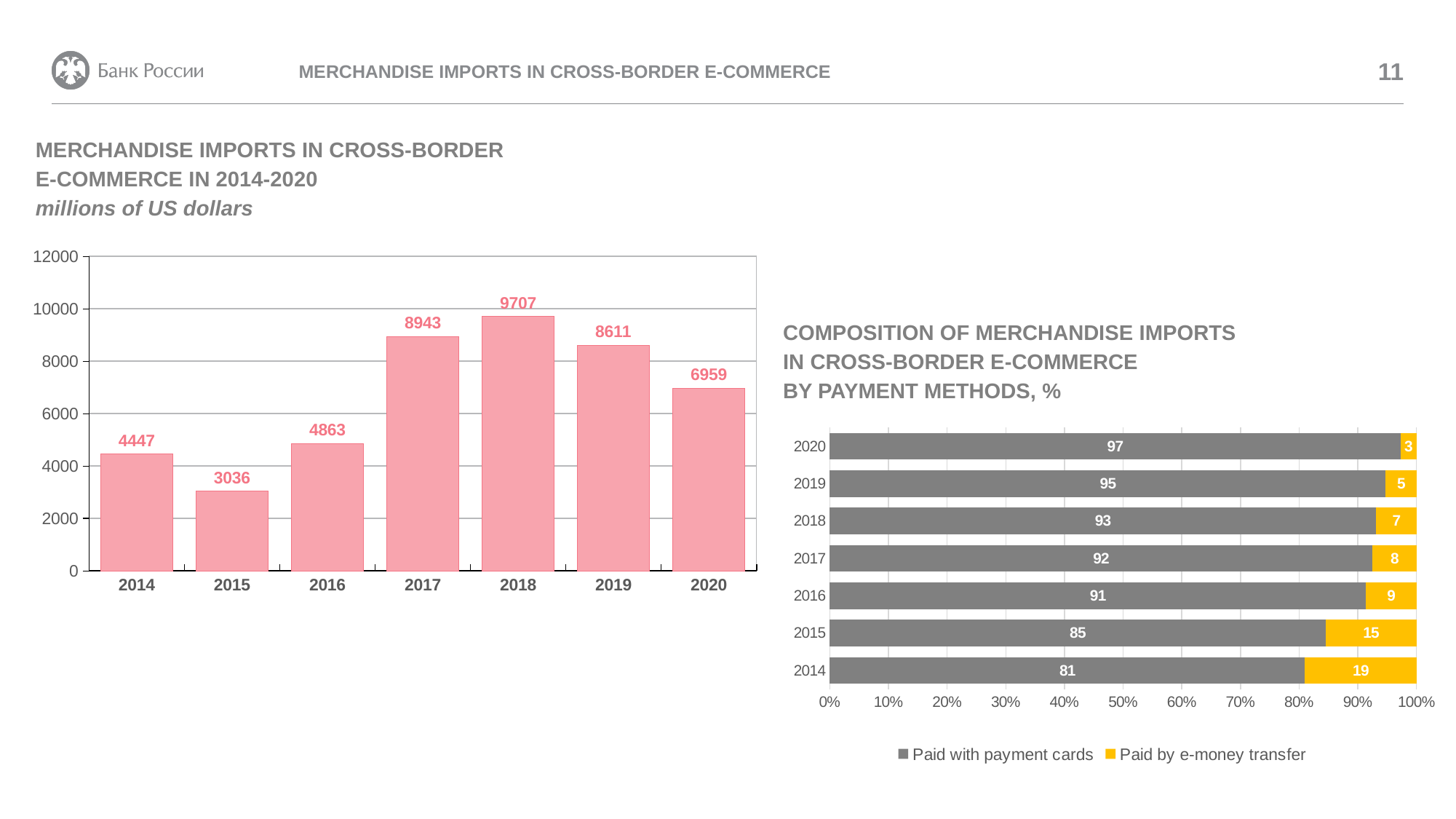
How many years are shown in the 'Merchandise imports in cross-border e-commerce in 2014-2020' chart? 7 In the 'Merchandise imports in cross-border e-commerce in 2014-2020' chart, what is the difference between the values for 2018 and 2020? 2748 In the 'Composition of merchandise imports in cross-border e-commerce by payment methods' chart, what is the share paid by e-money transfer in 2015? 15 In the 'Merchandise imports in cross-border e-commerce in 2014-2020' chart, which is larger, the value for 2017 or the value for 2019? 2017 In the 'Merchandise imports in cross-border e-commerce in 2014-2020' chart, which year has the highest value? 2018 In the 'Composition of merchandise imports in cross-border e-commerce by payment methods' chart, what is the share paid with payment cards in 2020? 97 What kind of chart is the 'Merchandise imports in cross-border e-commerce in 2014-2020' chart? Bar chart How many series does the legend list in the 'Composition of merchandise imports in cross-border e-commerce by payment methods' chart? 2 In the 'Merchandise imports in cross-border e-commerce in 2014-2020' chart, which year has the lowest value? 2015 In the 'Composition of merchandise imports in cross-border e-commerce by payment methods' chart, does the share paid by e-money transfer rise or fall from 2014 to 2020? Fall In the 'Composition of merchandise imports in cross-border e-commerce by payment methods' chart, what colour represents 'Paid by e-money transfer'? Yellow In the 'Merchandise imports in cross-border e-commerce in 2014-2020' chart, what is the value for 2018? 9707